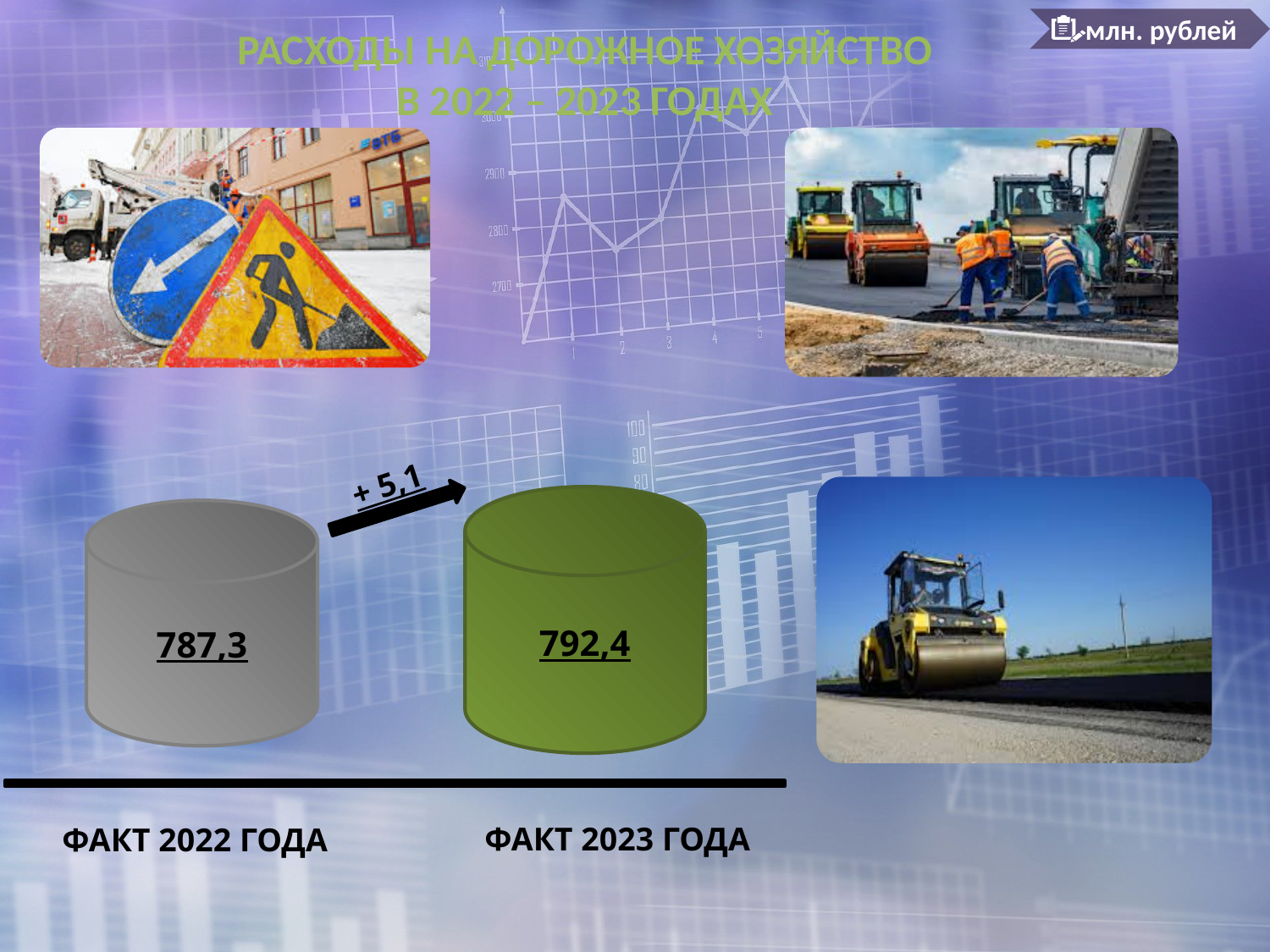
How many categories (years) are shown? 2 What is the value shown for ФАКТ 2023 ГОДА? 792,4 What is the title of the slide? РАСХОДЫ НА ДОРОЖНОЕ ХОЗЯЙСТВО В 2022 – 2023 ГОДАХ What unit of measurement is indicated in the top right corner of the slide? млн. рублей What is the value shown for ФАКТ 2022 ГОДА? 787,3 What is the difference between the 2023 value and the 2022 value? 5,1 Which category has the highest value? ФАКТ 2023 ГОДА Which year has the higher value, ФАКТ 2022 ГОДА or ФАКТ 2023 ГОДА? ФАКТ 2023 ГОДА Do the values rise or fall from 2022 to 2023? rise What change is written on the arrow between the two cylinders? + 5,1 Which category has the lowest value? ФАКТ 2022 ГОДА